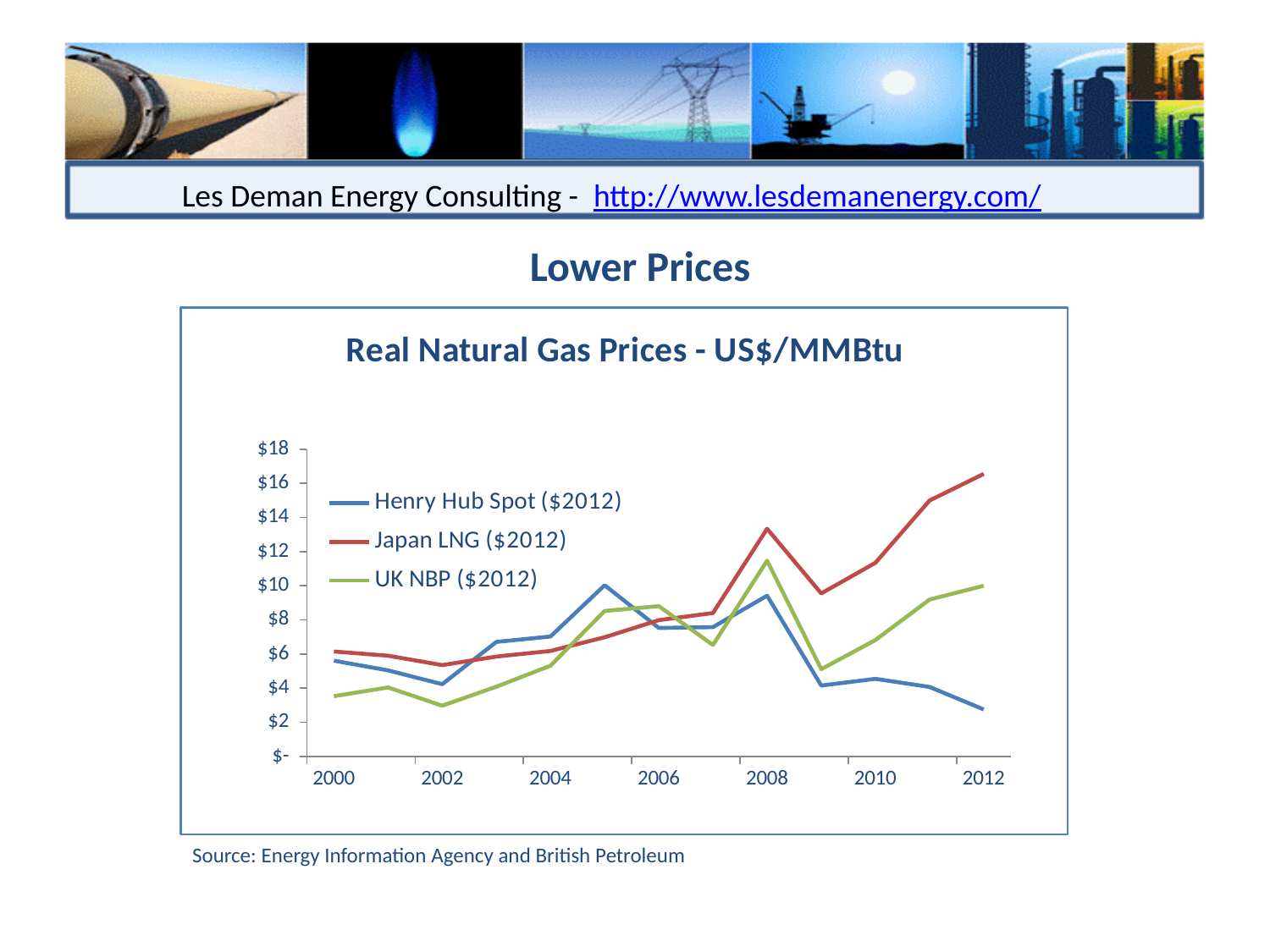
Is the value for UK NBP ($2012) in 2008 greater or less than $10? greater Which series is shown in green in the legend? UK NBP ($2012) What kind of chart is shown on the slide? Line chart Is the value for Henry Hub Spot ($2012) in 2000 greater or less than $4? greater Which series has the lowest value in 2012? Henry Hub Spot ($2012) What is the title of the chart? Real Natural Gas Prices - US$/MMBtu In 2000, which is higher: Henry Hub Spot ($2012) or UK NBP ($2012)? Henry Hub Spot ($2012) Does the Japan LNG ($2012) series rise or fall from 2009 to 2012? Rise How many series does the legend list? 3 Which series has the highest value in 2012? Japan LNG ($2012) Is the value for Henry Hub Spot ($2012) in 2012 greater or less than $4? less